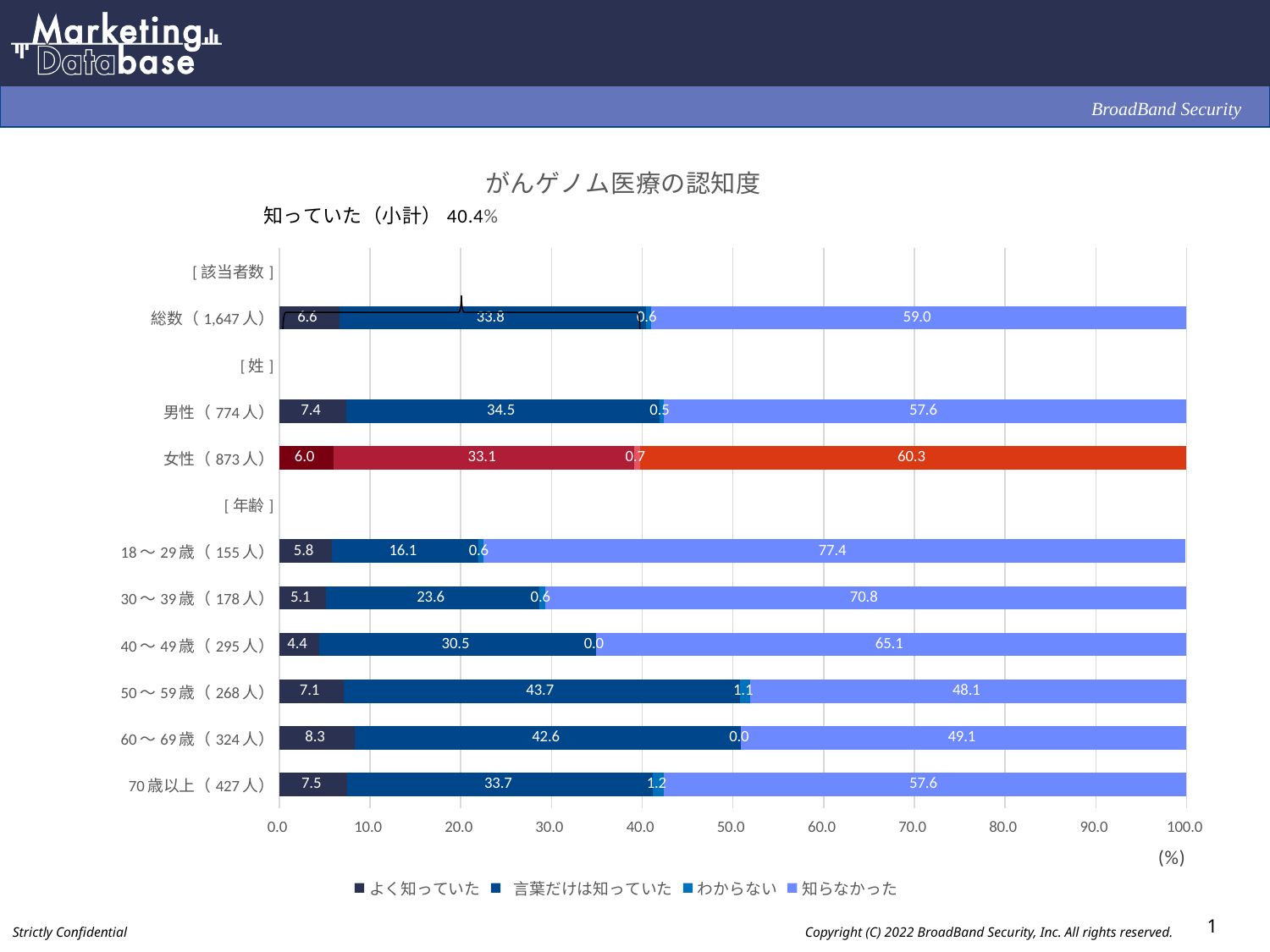
What is the value of 言葉だけは知っていた for 50〜59歳 (268人)? 43.7 What is the title of the chart? がんゲノム医療の認知度 Which is larger, the 言葉だけは知っていた value for 50〜59歳 (268人) or for 60〜69歳 (324人)? 50〜59歳 (268人) What is the 知っていた (小計) percentage shown above the chart? 40.4% What is the value of 知らなかった for 総数 (1,647人)? 59.0 What is the value of よく知っていた for 60〜69歳 (324人)? 8.3 Which category has the lowest value for よく知っていた? 40〜49歳 (295人) What is the difference between the 知らなかった values for 女性 (873人) and 男性 (774人)? 2.7 What is the value of わからない for 70歳以上 (427人)? 1.2 What type of chart is shown on the slide? Stacked bar chart Which category has the highest value for 知らなかった? 18〜29歳 (155人) How many series does the legend list? 4